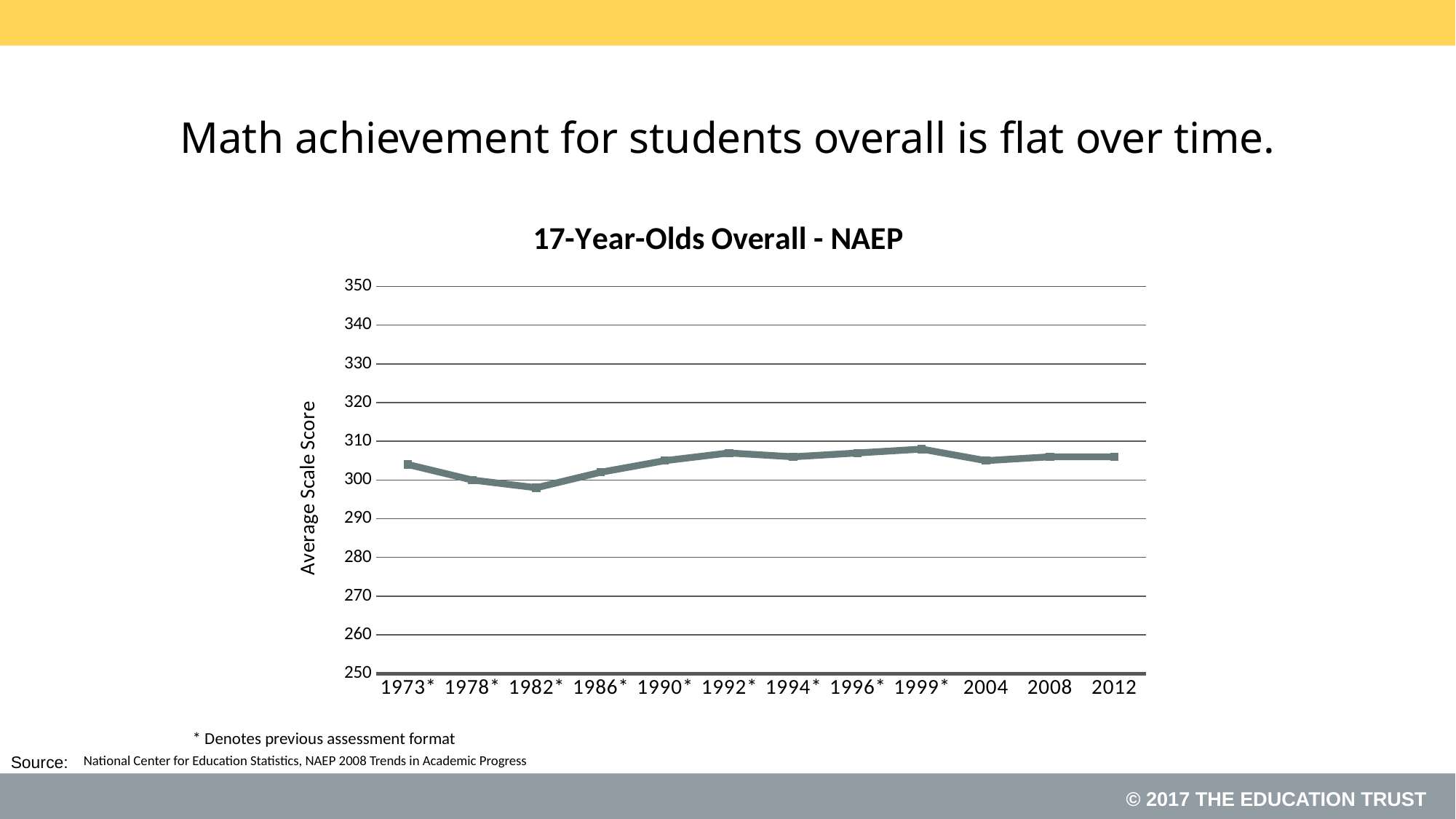
Is the value for 1999* greater or less than 310? less Is the value for 2012 greater or less than 300? greater What kind of chart is shown on the slide? line chart What is the label on the vertical axis of the chart? Average Scale Score Is the value for 1973* greater or less than 300? greater What is the title of the chart? 17-Year-Olds Overall - NAEP Which is larger, the value for 1973* or the value for 1982*? 1973* Do the values rise or fall from 1973* to 1982*? fall Which year has the lowest average scale score? 1982* How many assessment years are plotted along the x axis? 12 Which is larger, the value for 1978* or the value for 1992*? 1992*